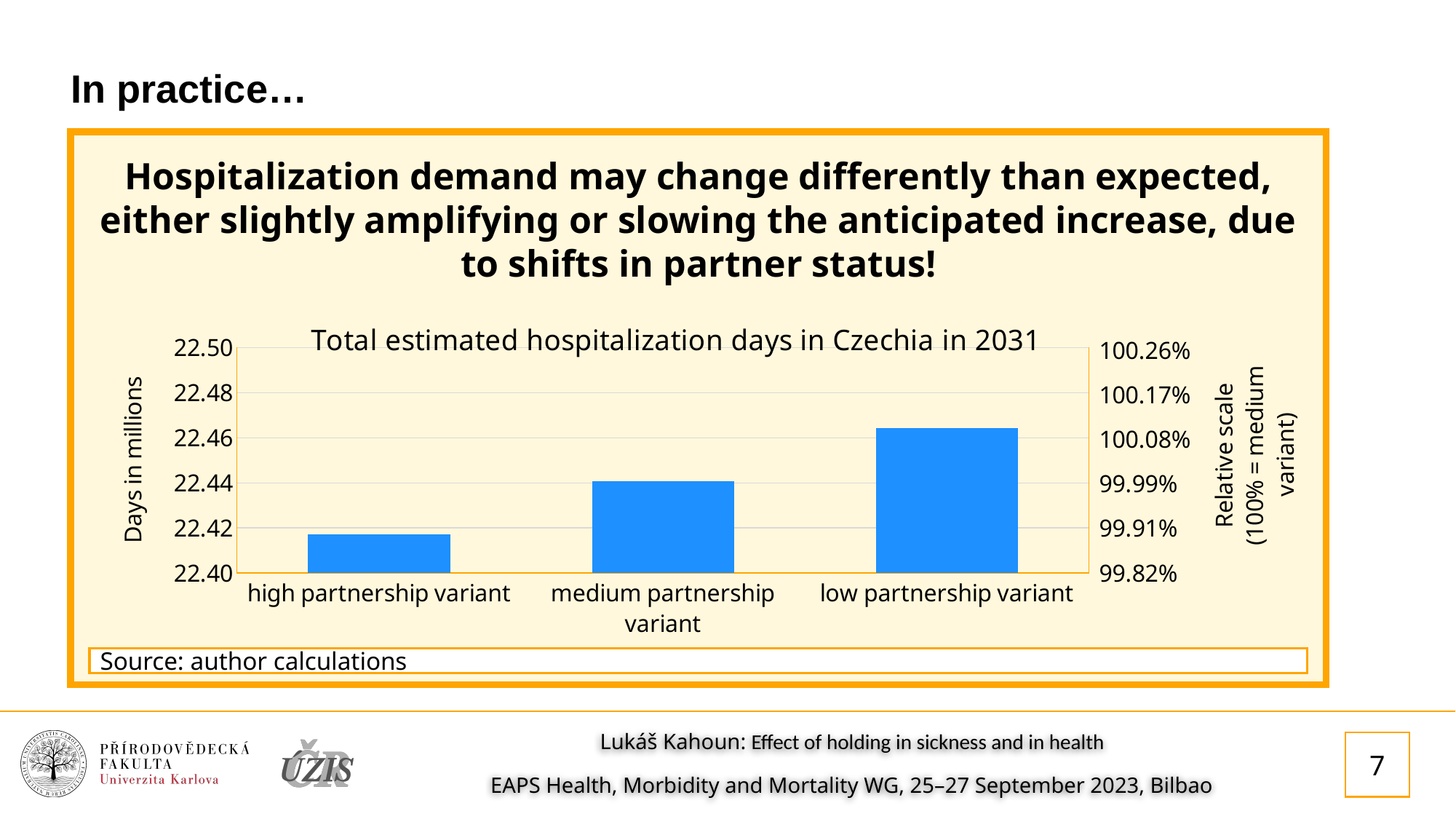
Do the bar values rise or fall moving from the high partnership variant to the low partnership variant? rise Is the value for the high partnership variant greater or less than 22.44 million days? less What is the label of the left vertical axis of the chart? Days in millions Which partnership variant has the highest total estimated hospitalization days? low partnership variant Which partnership variant has the lowest total estimated hospitalization days? high partnership variant Which has more estimated hospitalization days, the medium partnership variant or the high partnership variant? medium partnership variant What is the title of the chart? Total estimated hospitalization days in Czechia in 2031 How many partnership variants are plotted in the chart? 3 Is the value for the medium partnership variant greater or less than 22.42 million days? greater Is the value for the low partnership variant greater or less than 22.44 million days? greater What kind of chart is shown on the slide? bar chart